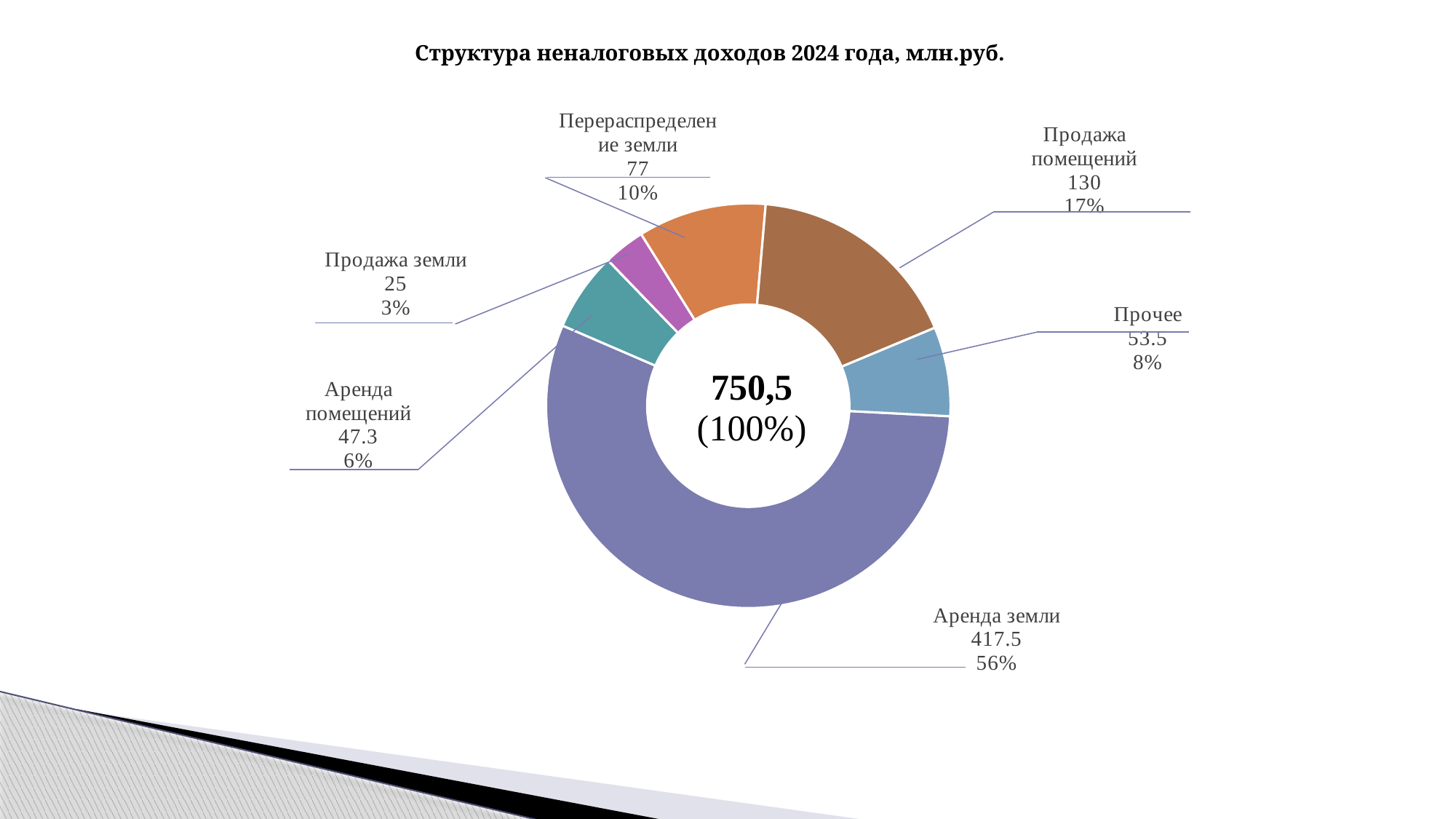
Which category has the largest value? Аренда земли How many categories are shown in the chart? 6 What is the value for Прочее? 53.5 What is the value for Аренда земли? 417.5 What is the value for Продажа помещений? 130 What is the difference between the values for Продажа помещений and Перераспределение земли? 53 Which is larger, the value for Прочее or the value for Аренда помещений? Прочее What share of the total does Аренда помещений represent? 6% What type of chart is shown on the slide? Doughnut (pie) chart What share of the total does Перераспределение земли represent? 10% What total value is shown in the centre of the chart? 750,5 (100%) Which category has the smallest value? Продажа земли